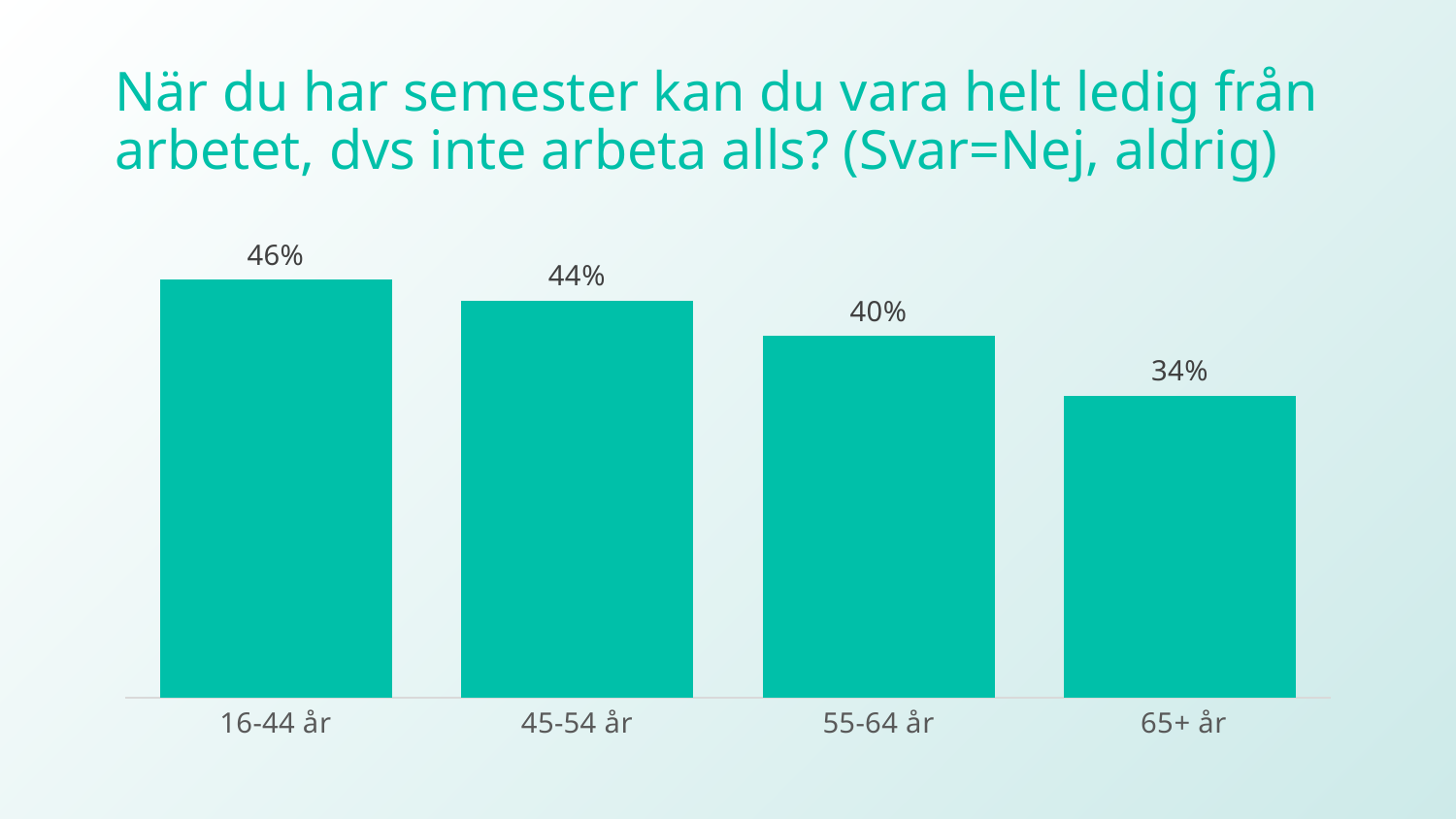
What is the value for the 45-54 år age group? 44% Which age group has the lowest value? 65+ år What is the value for the 16-44 år age group? 46% Do the values rise or fall from the youngest to the oldest age group? Fall What kind of chart is shown on the slide? Bar chart How many age groups are shown in the chart? 4 What is the value for the 65+ år age group? 34% What is the difference between the values for 16-44 år and 65+ år? 12% What is the value for the 55-64 år age group? 40% Which is larger, the value for 55-64 år or the value for 65+ år? 55-64 år What is the difference between the values for 45-54 år and 55-64 år? 4% Which age group has the highest value? 16-44 år